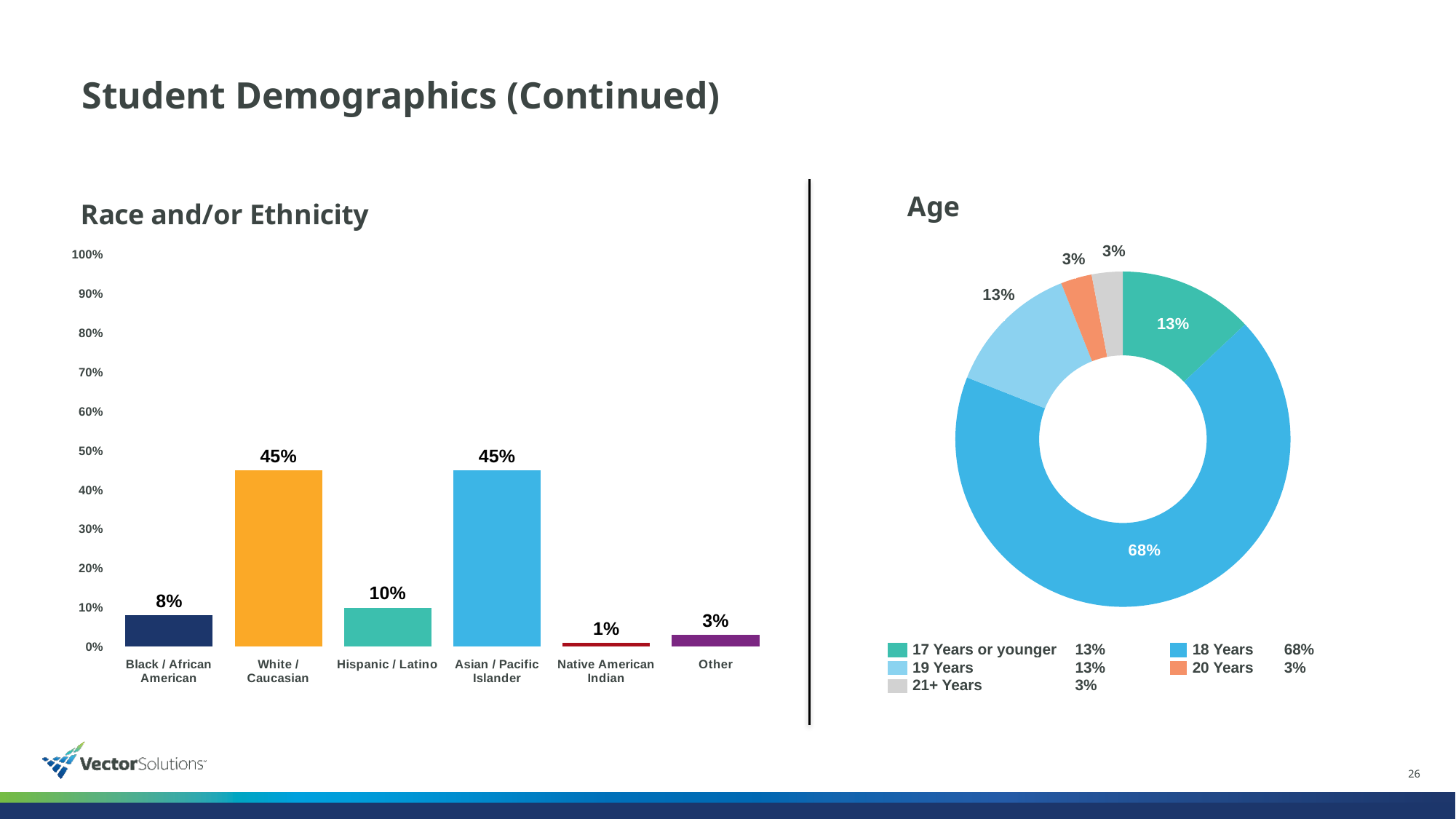
In the Race and/or Ethnicity chart, what is the value for Black / African American? 8% In the Age chart, what share of students are 18 Years? 68% How many age groups does the legend of the Age chart list? 5 In the Race and/or Ethnicity chart, what is the value for Hispanic / Latino? 10% In the Age chart, which age group has the largest share? 18 Years In the Race and/or Ethnicity chart, which is larger, Hispanic / Latino or Other? Hispanic / Latino In the Age chart, what share of students are 21+ Years? 3% What kind of chart is the Race and/or Ethnicity chart? Bar chart In the Race and/or Ethnicity chart, which category has the lowest value? Native American Indian What kind of chart is the Age chart? Doughnut chart How many categories are shown in the Race and/or Ethnicity chart? 6 In the Race and/or Ethnicity chart, what is the difference between White / Caucasian and Black / African American? 37%